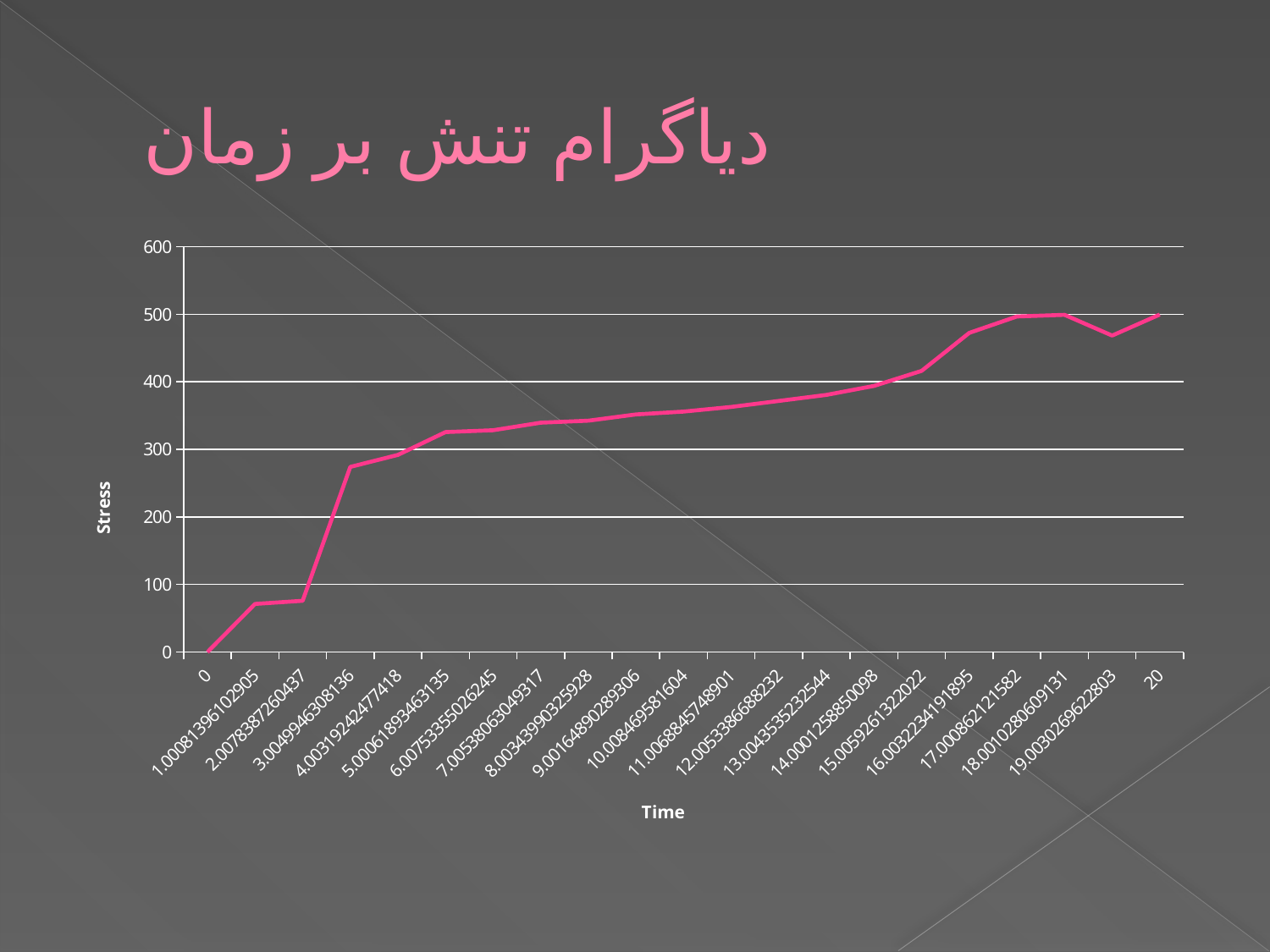
What is the title of the horizontal axis? Time Is the Stress value at Time 10.008469581604 greater or less than 300? greater Is the Stress value at Time 2.0078387260437 greater or less than 100? less Do the Stress values generally rise or fall as Time increases? rise What is the title of the vertical axis? Stress How many data points are plotted along the Time axis? 21 Is the Stress value at Time 4.0031924247741 greater or less than 200? greater What is the Stress value at Time 0? 0 What kind of chart is shown on the slide? line chart At which Time value is Stress lowest? 0 Which has the larger Stress value: Time 2.0078387260437 or Time 4.0031924247741? 4.0031924247741